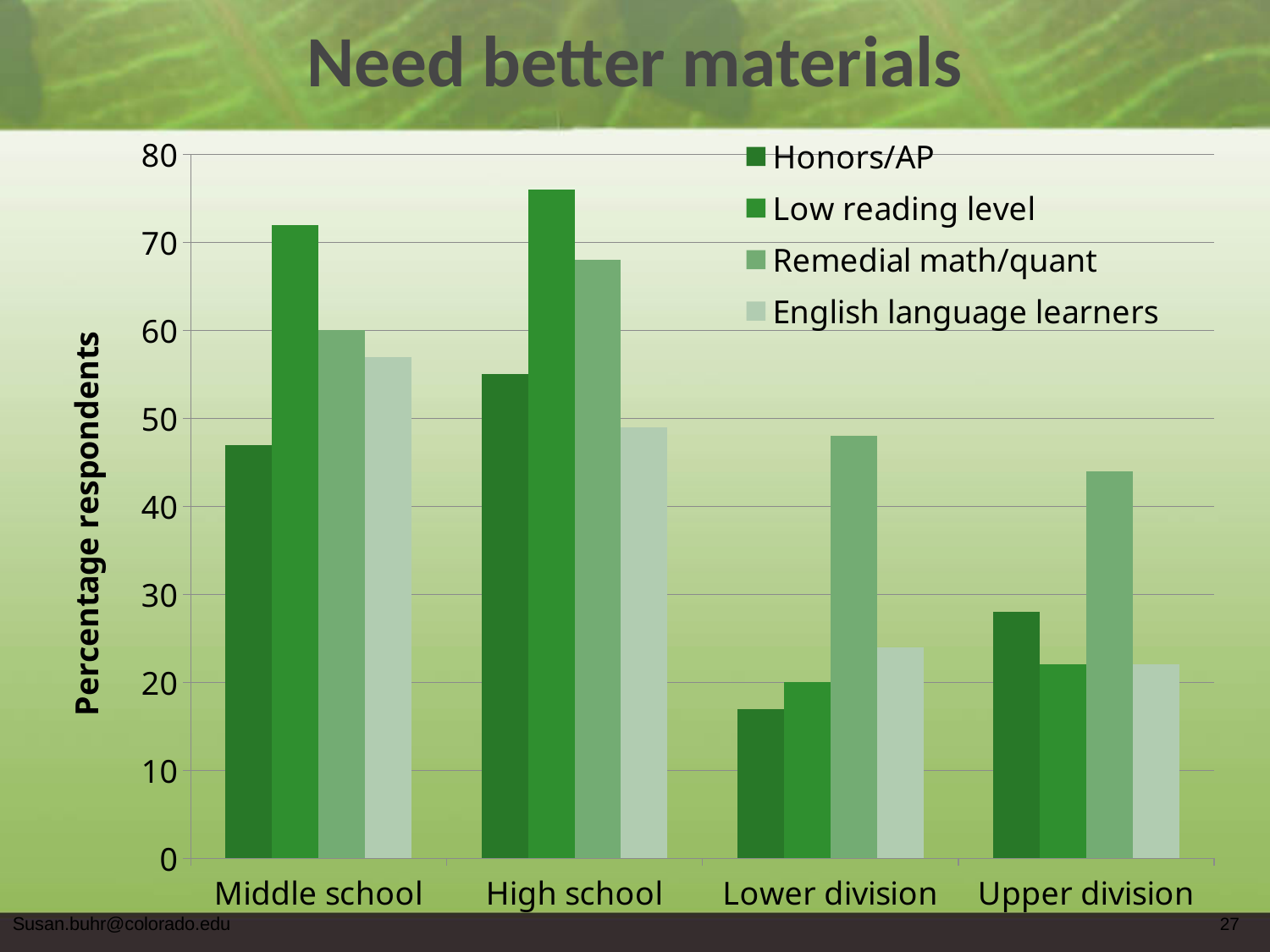
What kind of chart is shown on the slide? bar chart Which series has the lowest value at Lower division? Honors/AP Which is larger, the Honors/AP value for Middle school or for High school? High school What is the title of the chart? Need better materials Is the value for English language learners at Middle school greater or less than 50? greater How many categories are shown on the x axis? 4 What is the label on the vertical axis? Percentage respondents Which category has the highest value for Low reading level? High school How many series does the legend list? 4 Is the value for Honors/AP at High school greater or less than 50? greater Is the value for Honors/AP at Lower division greater or less than 20? less